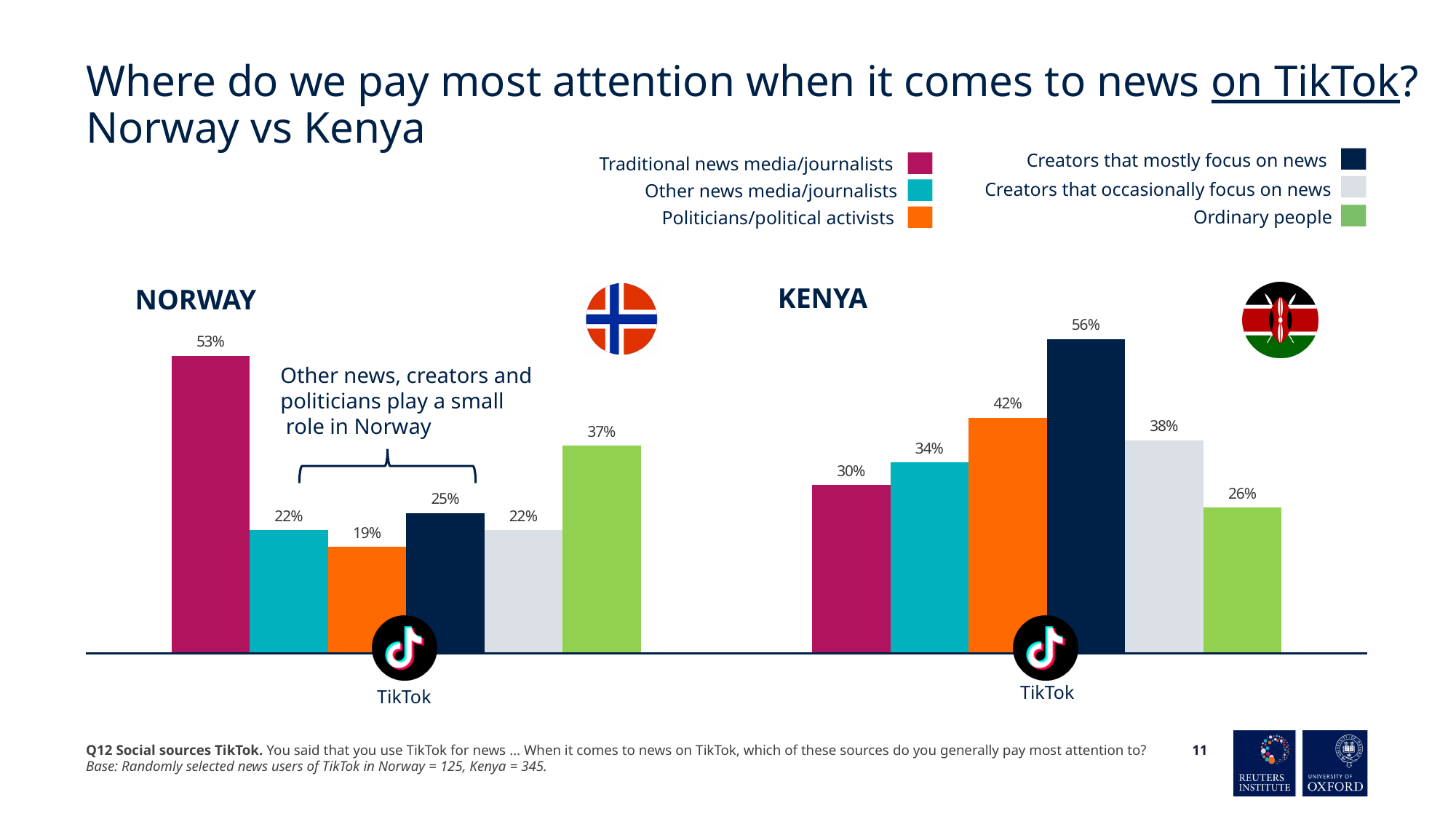
In the Kenya chart, what is the value for politicians/political activists? 42% Which is larger: the value for ordinary people in Norway or in Kenya? Norway What is the difference between the Kenya value for creators that mostly focus on news and the Norway value for the same source? 31 percentage points In the Norway chart, which source has the lowest value? Politicians/political activists In the Norway chart, what percentage pay most attention to traditional news media/journalists on TikTok? 53% What kind of chart is used for the Norway and Kenya data? Bar chart In the Kenya chart, what percentage pay most attention to creators that mostly focus on news? 56% In the Kenya chart, which source has the lowest value? Ordinary people In the Norway chart, which source has the highest value? Traditional news media/journalists In the Norway chart, what is the value for ordinary people? 37% How many series does the legend list? 6 Which colour represents creators that occasionally focus on news in the legend? Light grey